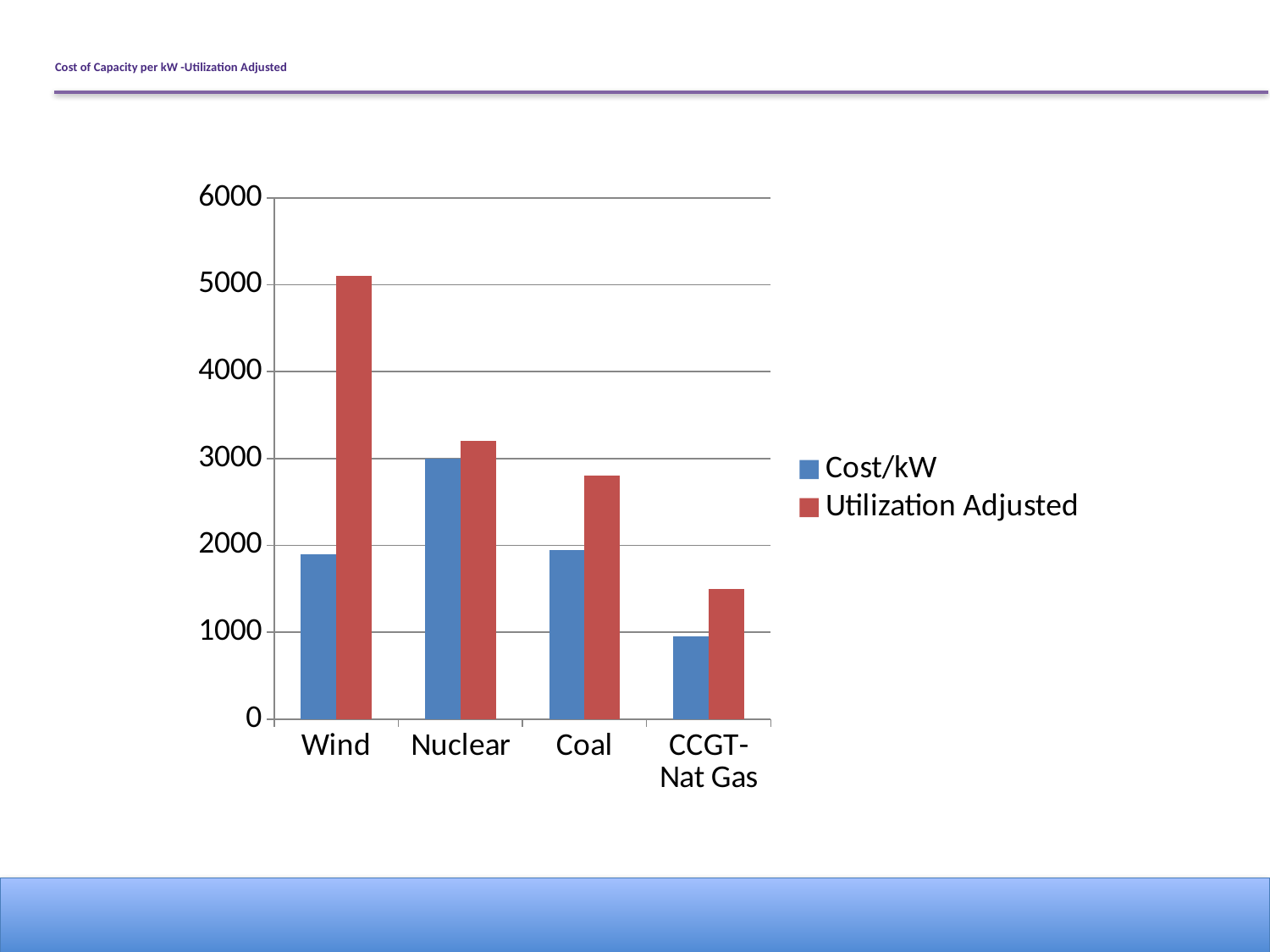
What are the two series named in the chart's legend? Cost/kW and Utilization Adjusted Which category has the lowest Cost/kW value? CCGT-Nat Gas Is the Utilization Adjusted value for Coal greater or less than 3000? less Which category has the lowest Utilization Adjusted value? CCGT-Nat Gas Is the Utilization Adjusted value for Wind greater or less than 5000? greater Is the Cost/kW value for CCGT-Nat Gas greater or less than 1000? less How many categories are shown on the x axis of the chart? 4 What kind of chart is shown on the slide? bar chart Which is larger, the Cost/kW value for Nuclear or the Cost/kW value for Coal? Nuclear Which category has the highest Utilization Adjusted value? Wind How many series does the chart's legend list? 2 Which category has the highest Cost/kW value? Nuclear